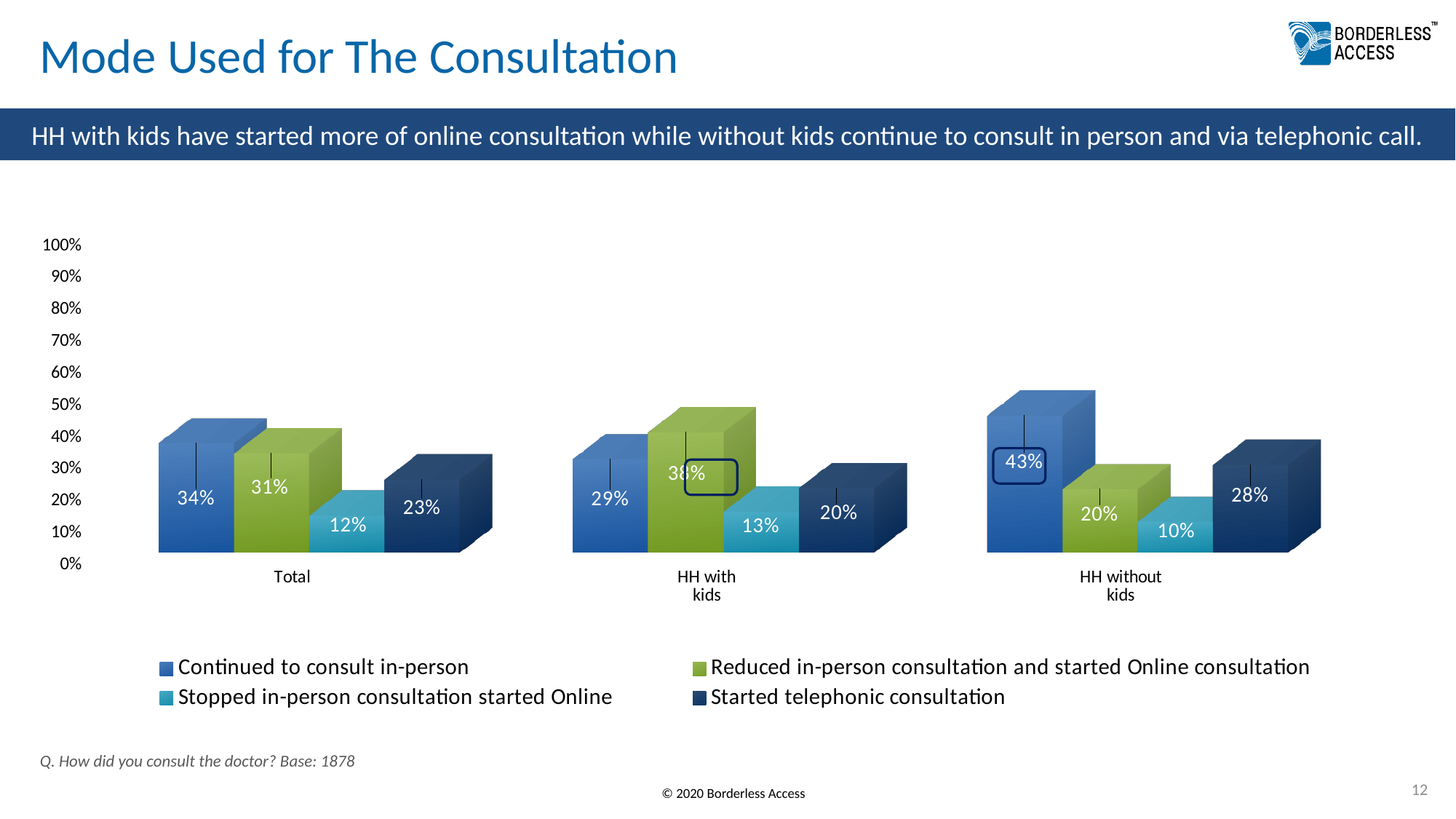
Which is larger for HH with kids: 'Continued to consult in-person' or 'Reduced in-person consultation and started Online consultation'? Reduced in-person consultation and started Online consultation What is the value for 'Stopped in-person consultation started Online' for HH with kids? 13% Which category has the highest value for 'Continued to consult in-person'? HH without kids How many series does the legend list? 4 How many categories are shown on the x axis? 3 What is the difference between 'Continued to consult in-person' for HH without kids and for HH with kids? 14% What is the value for 'Reduced in-person consultation and started Online consultation' for HH without kids? 20% What is the value for 'Started telephonic consultation' for HH without kids? 28% What kind of chart is shown on the slide? Bar chart What is the value for 'Continued to consult in-person' in the Total category? 34% Which series has the lowest value in the HH without kids category? Stopped in-person consultation started Online What is the title of the slide? Mode Used for The Consultation